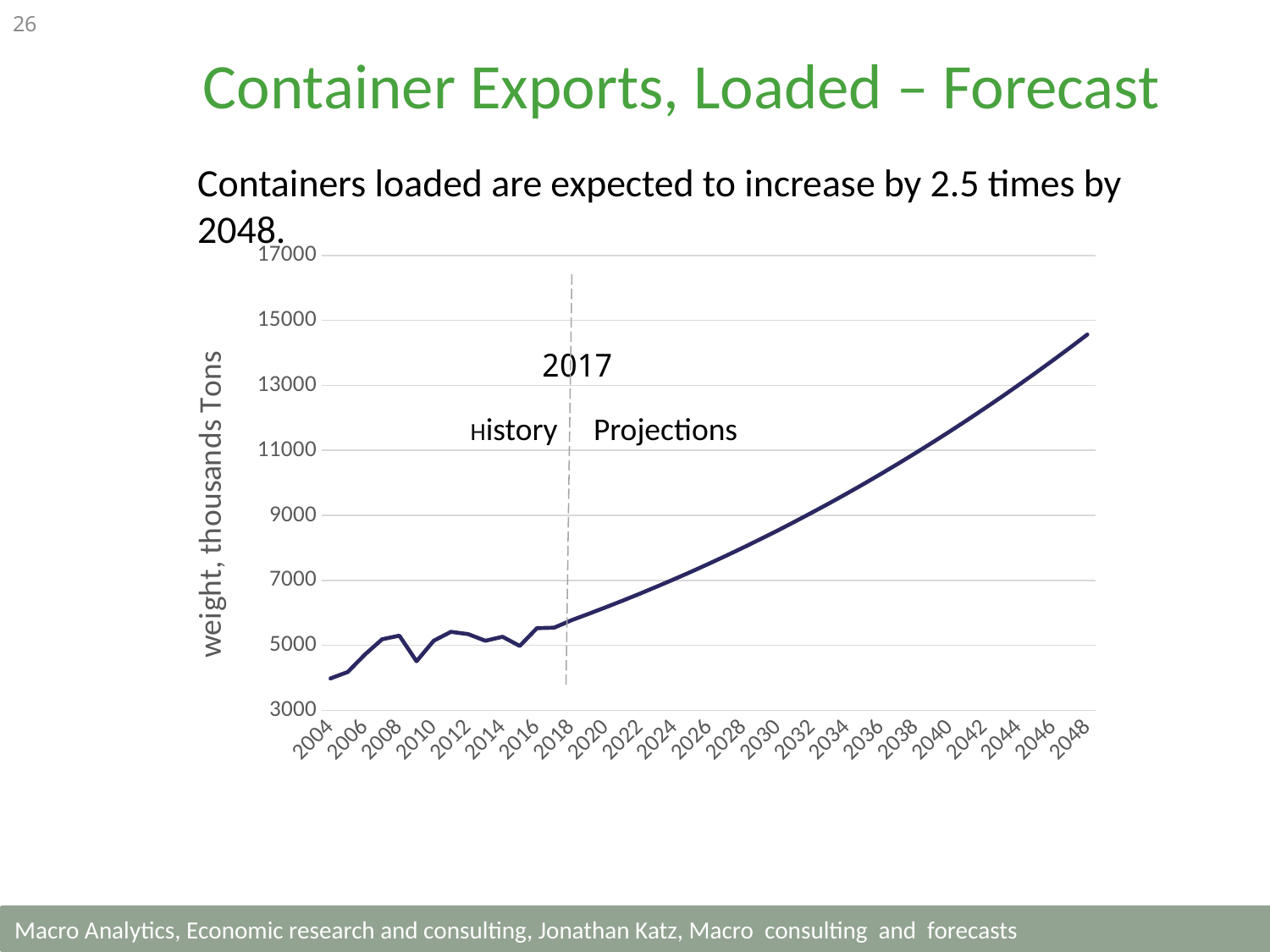
Do the values generally rise or fall from 2004 to 2048? rise What is the label on the y axis of the chart? weight, thousands Tons Is the value for 2024 greater or less than 9000? less What kind of chart is shown on the slide? line chart Which year has the highest value on the chart? 2048 Is the value for 2048 greater or less than 13000? greater Is the value for 2004 greater or less than 5000? less Which is larger, the value for 2012 or the value for 2009? 2012 Which year has the lowest value on the chart? 2004 Which is larger, the value for 2048 or the value for 2017? 2048 Which year does the dashed vertical line separating History from Projections mark? 2017